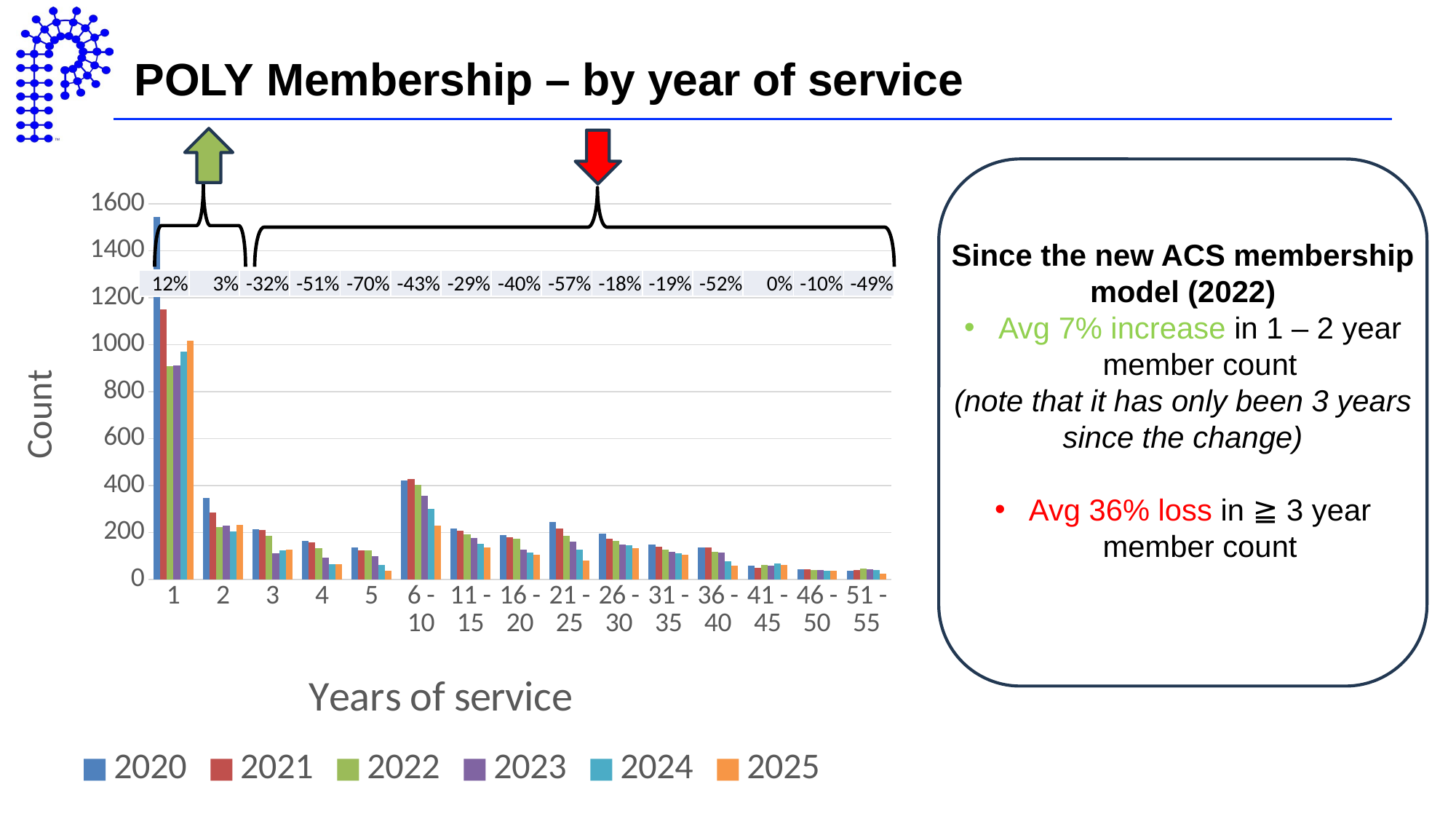
What kind of chart is shown on the slide? bar chart Is the 2021 value for 1 year of service greater or less than 1000? greater How many years-of-service categories are shown on the x axis? 15 For 1 year of service, which is larger: the 2020 value or the 2025 value? 2020 Is the 2020 value for 1 year of service greater or less than 1400? greater Is the 2025 value for 51 - 55 years of service greater or less than 200? less What is the title of the x axis? Years of service What is the title of the y axis? Count Which years-of-service category has the highest member count? 1 How many series does the legend list? 6